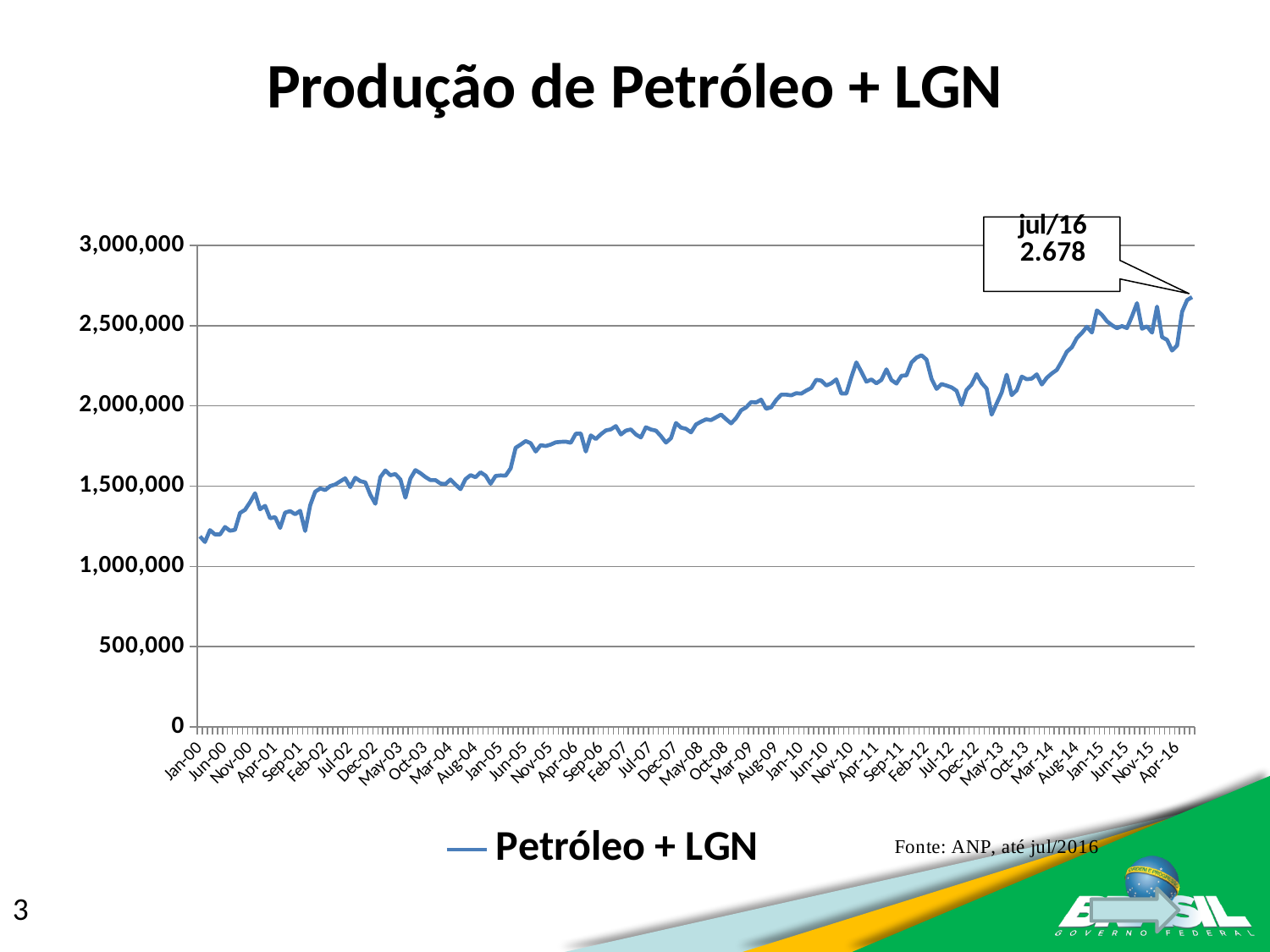
What is the highest value shown on the y axis? 3,000,000 Is the value for Jan-00 greater or less than 1,500,000? less What is the title of the chart? Produção de Petróleo + LGN Overall, do the values rise or fall from Jan-00 to Apr-16? rise Is the value for Jan-08 greater or less than 2,000,000? less What is the name of the series shown in the legend? Petróleo + LGN Is the value for Jan-10 greater or less than 2,000,000? greater What kind of chart is shown on the slide? line chart How many series does the legend list? 1 What value does the callout label give for jul/16? 2.678 Which is larger, the value for Jan-00 or the value for Apr-16? Apr-16